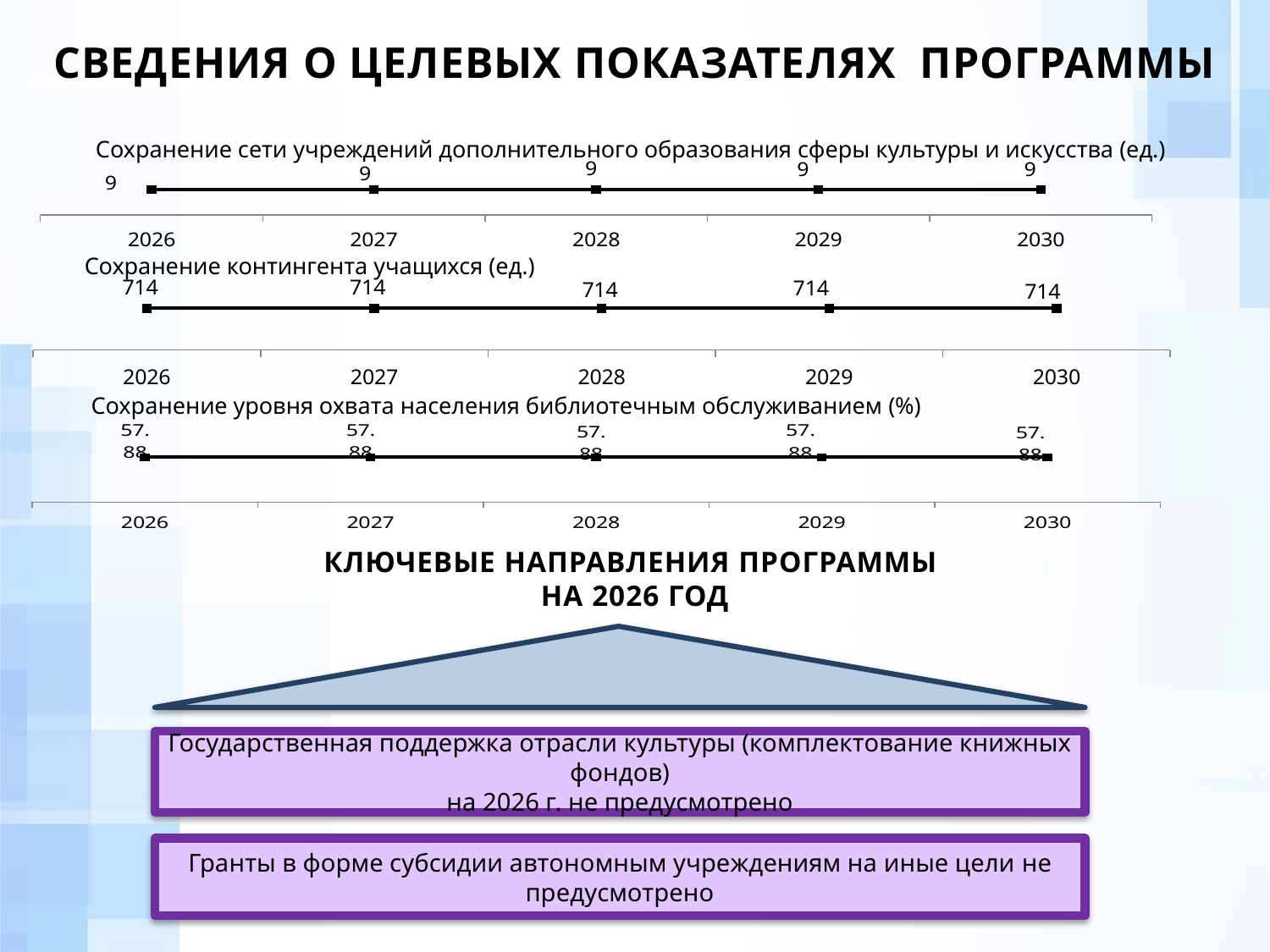
In the chart titled "Сохранение сети учреждений дополнительного образования сферы культуры и искусства (ед.)", do the values rise, fall or stay flat across the years? Stay flat How many years are plotted in the chart titled "Сохранение сети учреждений дополнительного образования сферы культуры и искусства (ед.)"? 5 In the chart titled "Сохранение контингента учащихся (ед.)", what is the difference between the values for 2030 and 2026? 0 What kind of chart is the chart titled "Сохранение контингента учащихся (ед.)"? Line chart In the chart titled "Сохранение контингента учащихся (ед.)", what is the value for 2026? 714 What is the first year shown on the x axis of the chart titled "Сохранение уровня охвата населения библиотечным обслуживанием (%)"? 2026 In the chart titled "Сохранение контингента учащихся (ед.)", what is the value for 2030? 714 In the chart titled "Сохранение уровня охвата населения библиотечным обслуживанием (%)", what is the value for 2027? 57.88 In the chart titled "Сохранение уровня охвата населения библиотечным обслуживанием (%)", is the value for 2029 greater or less than 50? greater In the chart titled "Сохранение контингента учащихся (ед.)", do the values rise, fall or stay the same from 2026 to 2030? Stay the same In the chart titled "Сохранение сети учреждений дополнительного образования сферы культуры и искусства (ед.)", what is the value for 2028? 9 How many data points are plotted in the chart titled "Сохранение уровня охвата населения библиотечным обслуживанием (%)"? 5